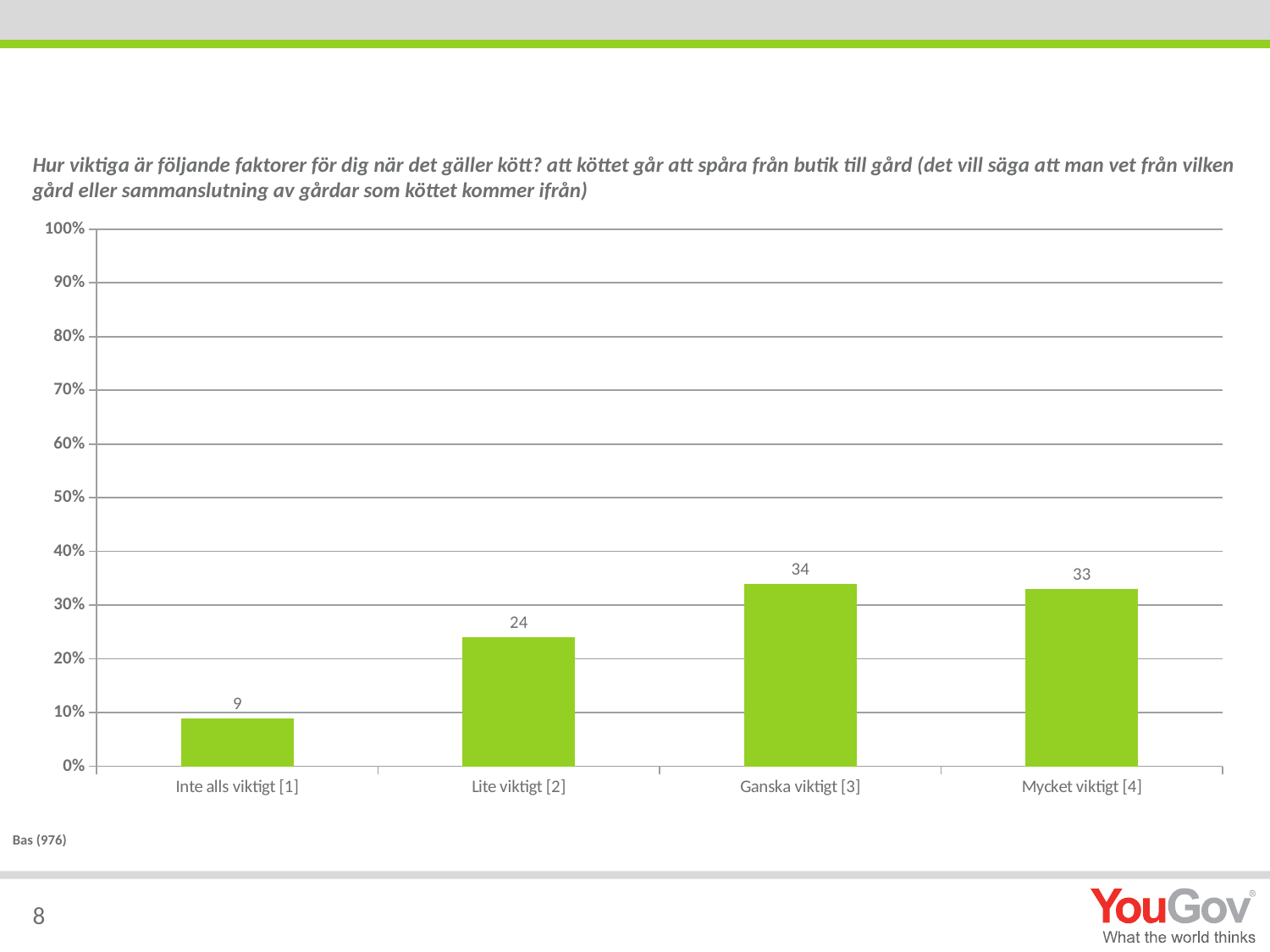
Which is larger, the value for Lite viktigt [2] or the value for Mycket viktigt [4]? Mycket viktigt [4] How many categories are shown on the x axis? 4 Is the value for Lite viktigt [2] greater or less than 30%? less What base size (Bas) is stated below the chart? 976 Which category has the highest value? Ganska viktigt [3] What is the value for Mycket viktigt [4]? 33 What kind of chart is shown on the slide? bar chart What is the value for Ganska viktigt [3]? 34 What is the value for Lite viktigt [2]? 24 What is the value for Inte alls viktigt [1]? 9 What is the difference between the values for Ganska viktigt [3] and Lite viktigt [2]? 10 Which category has the lowest value? Inte alls viktigt [1]